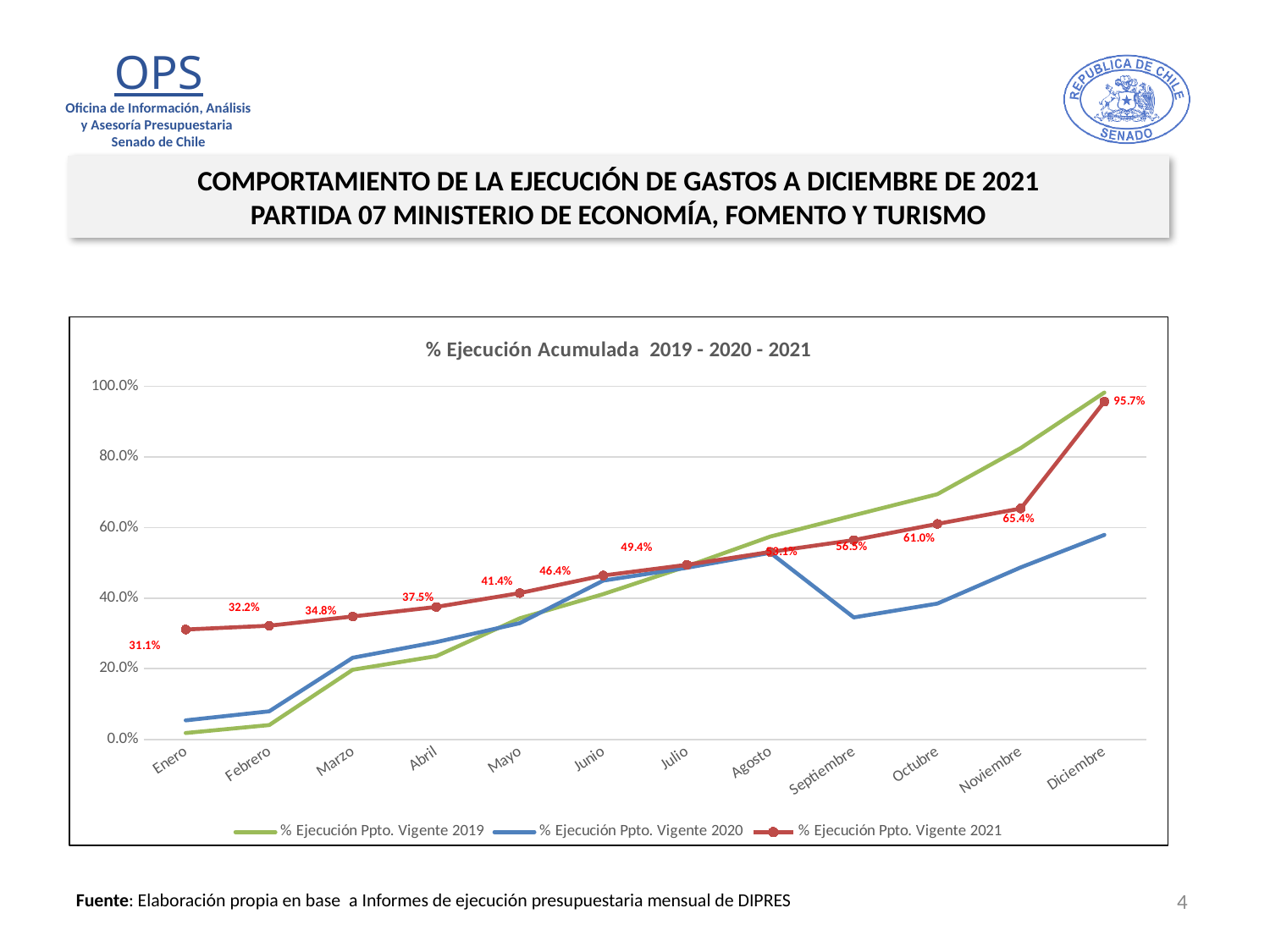
Which series has the larger value in Diciembre, % Ejecución Ppto. Vigente 2019 or % Ejecución Ppto. Vigente 2020? % Ejecución Ppto. Vigente 2019 What is the difference between the Febrero and Enero values in the % Ejecución Ppto. Vigente 2021 series? 1.1% What kind of chart is shown on the slide? Line chart What is the difference between the Diciembre and Noviembre values in the % Ejecución Ppto. Vigente 2021 series? 30.3% Do the values of the % Ejecución Ppto. Vigente 2021 series rise or fall from Enero to Diciembre? Rise How many series does the legend list? 3 What is the value for Mayo in the % Ejecución Ppto. Vigente 2021 series? 41.4% Is the value for Septiembre in the % Ejecución Ppto. Vigente 2020 series greater or less than 40.0%? less How many months are shown on the x axis? 12 What is the value for Diciembre in the % Ejecución Ppto. Vigente 2021 series? 95.7% What is the value for Enero in the % Ejecución Ppto. Vigente 2021 series? 31.1% What is the value for Noviembre in the % Ejecución Ppto. Vigente 2021 series? 65.4%